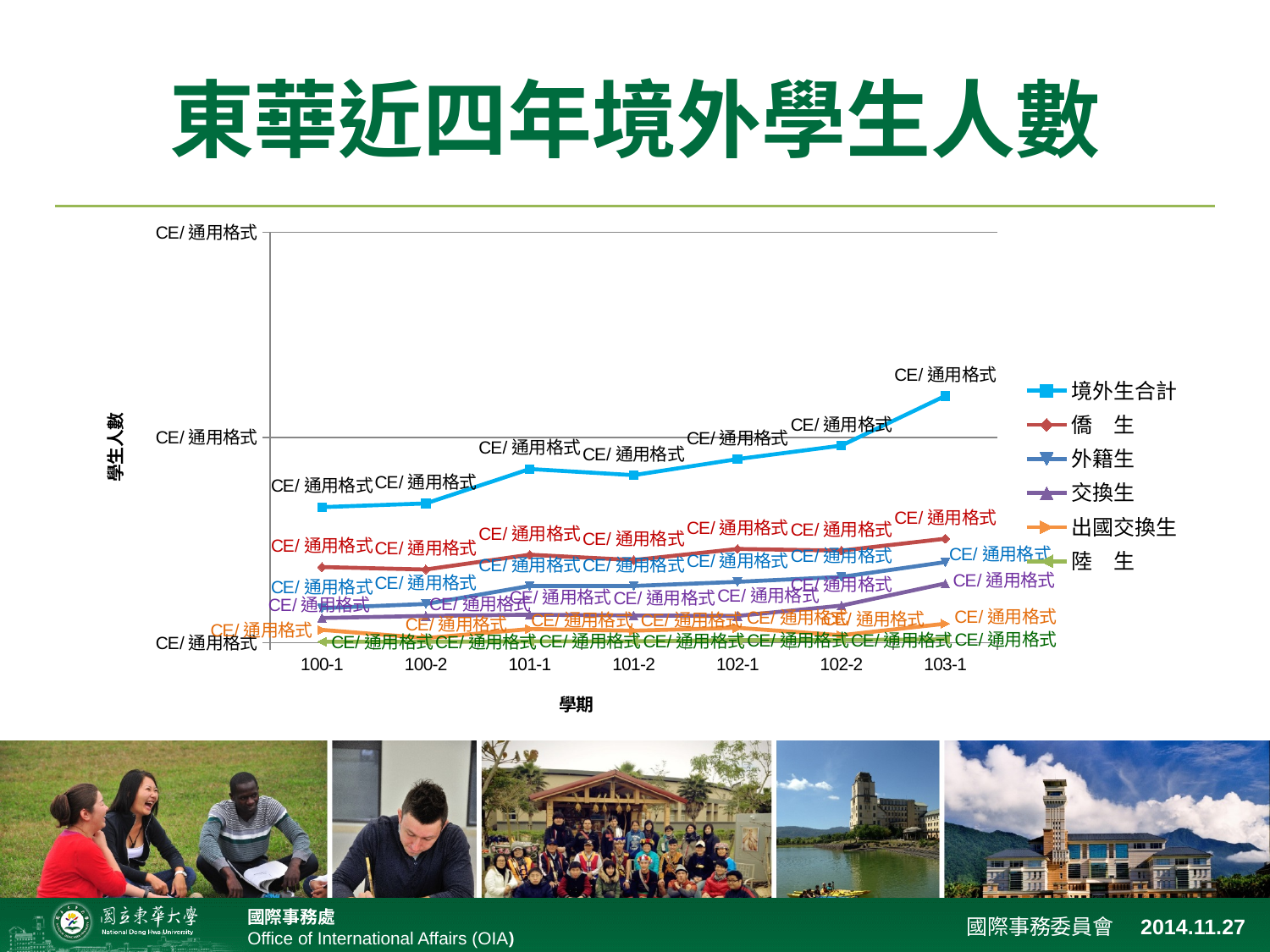
Does the 境外生合計 line rise or fall from 100-1 to 103-1? Rise At 103-1, which is larger: 僑生 or 外籍生? 僑生 How many series does the chart's legend list? 6 Which semester is the first category on the x axis? 100-1 What kind of chart is shown on the slide? Line chart What is the label of the x axis? 學期 Which series has the highest values across all semesters? 境外生合計 At 100-1, which is larger: 交換生 or 出國交換生? 交換生 Which semester is the last category on the x axis? 103-1 Which series has the lowest values across all semesters? 陸生 How many semesters (x-axis categories) are plotted on the chart? 7 What is the title of the slide's chart? 東華近四年境外學生人數